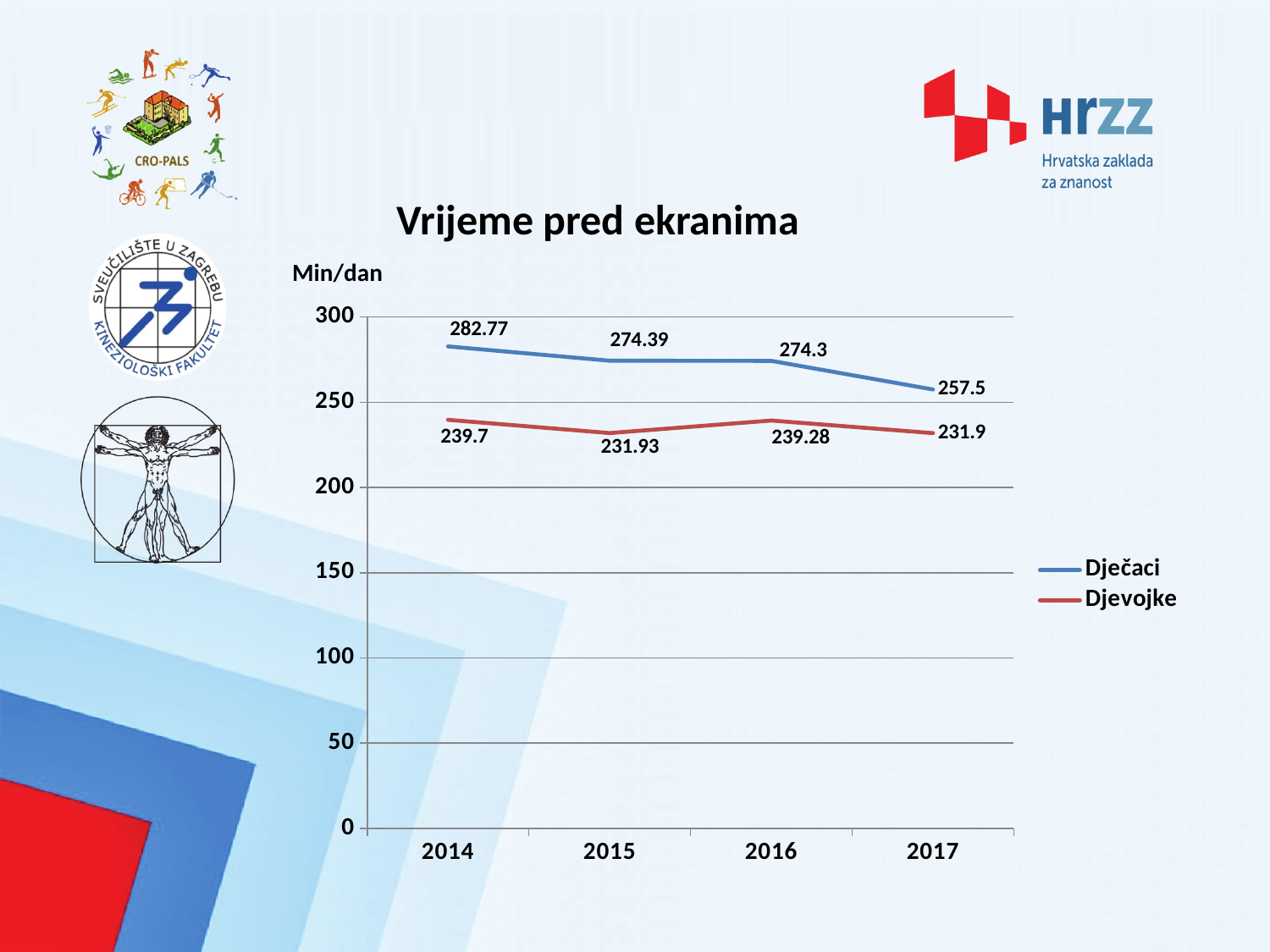
What is the value for Dječaci in 2014? 282.77 What is the difference between the Dječaci and Djevojke values in 2017? 25.6 In which year is the Djevojke value lowest? 2017 How many years are shown on the x axis? 4 What is the value for Dječaci in 2017? 257.5 What is the value for Djevojke in 2016? 239.28 Does the Dječaci series rise or fall from 2014 to 2017? fall How many series does the legend list? 2 What kind of chart is shown? line chart In which year is the Dječaci value highest? 2014 Which series has the larger value in 2015, Dječaci or Djevojke? Dječaci Is the value for Dječaci in 2016 greater or less than 250? greater